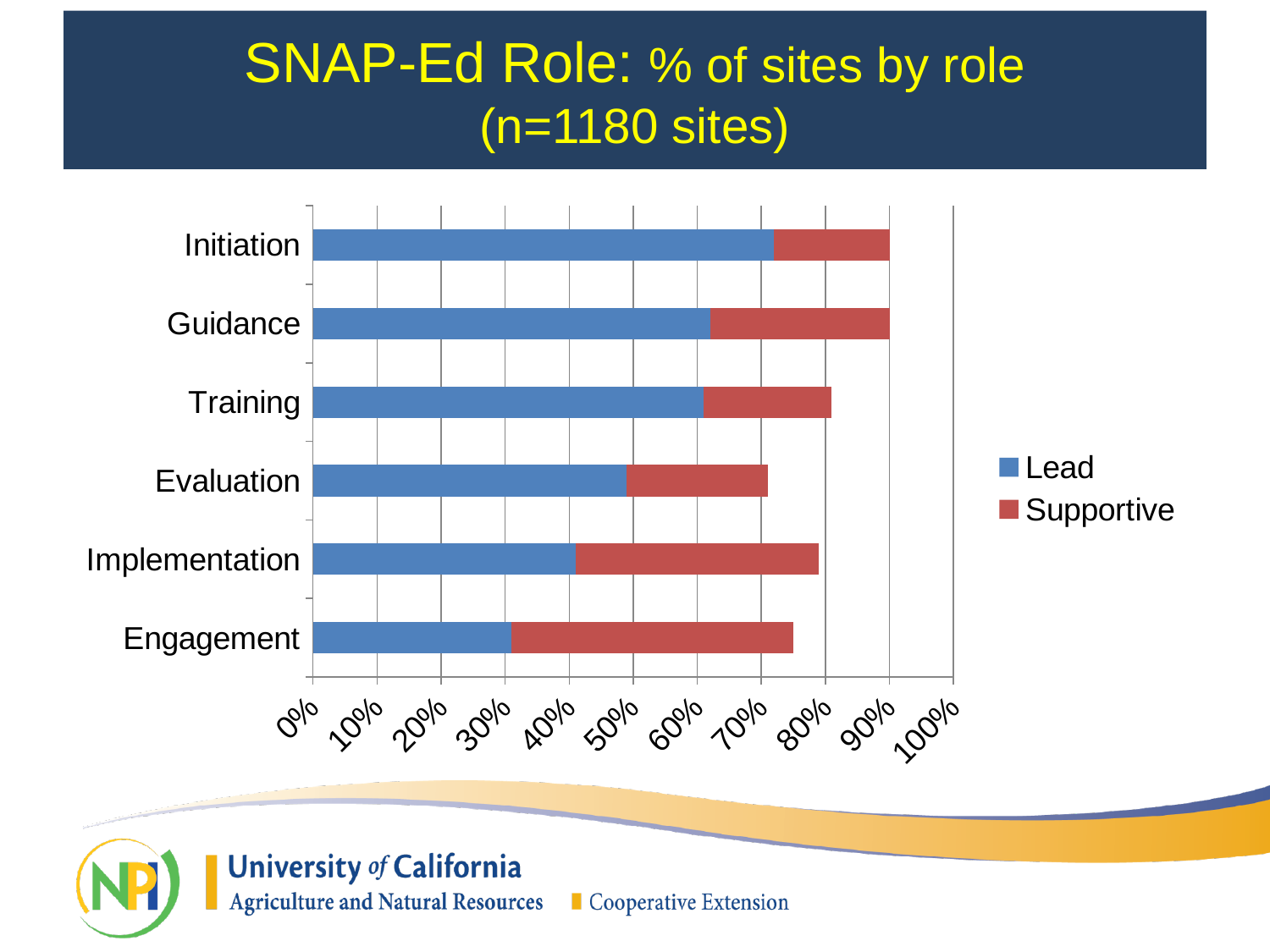
How many series does the legend list? 2 Which role has the lowest Lead value? Engagement Is the total (Lead plus Supportive) for Evaluation greater or less than 80%? less How many role categories are plotted on the chart? 6 What are the two series named in the legend? Lead, Supportive Is the Lead value for Initiation greater or less than 60%? greater Is the Lead value for Implementation greater or less than 50%? less What kind of chart is shown on the slide? bar chart Which role has the highest Lead value? Initiation What colour represents the Lead series? blue Which has the larger Lead value, Guidance or Evaluation? Guidance